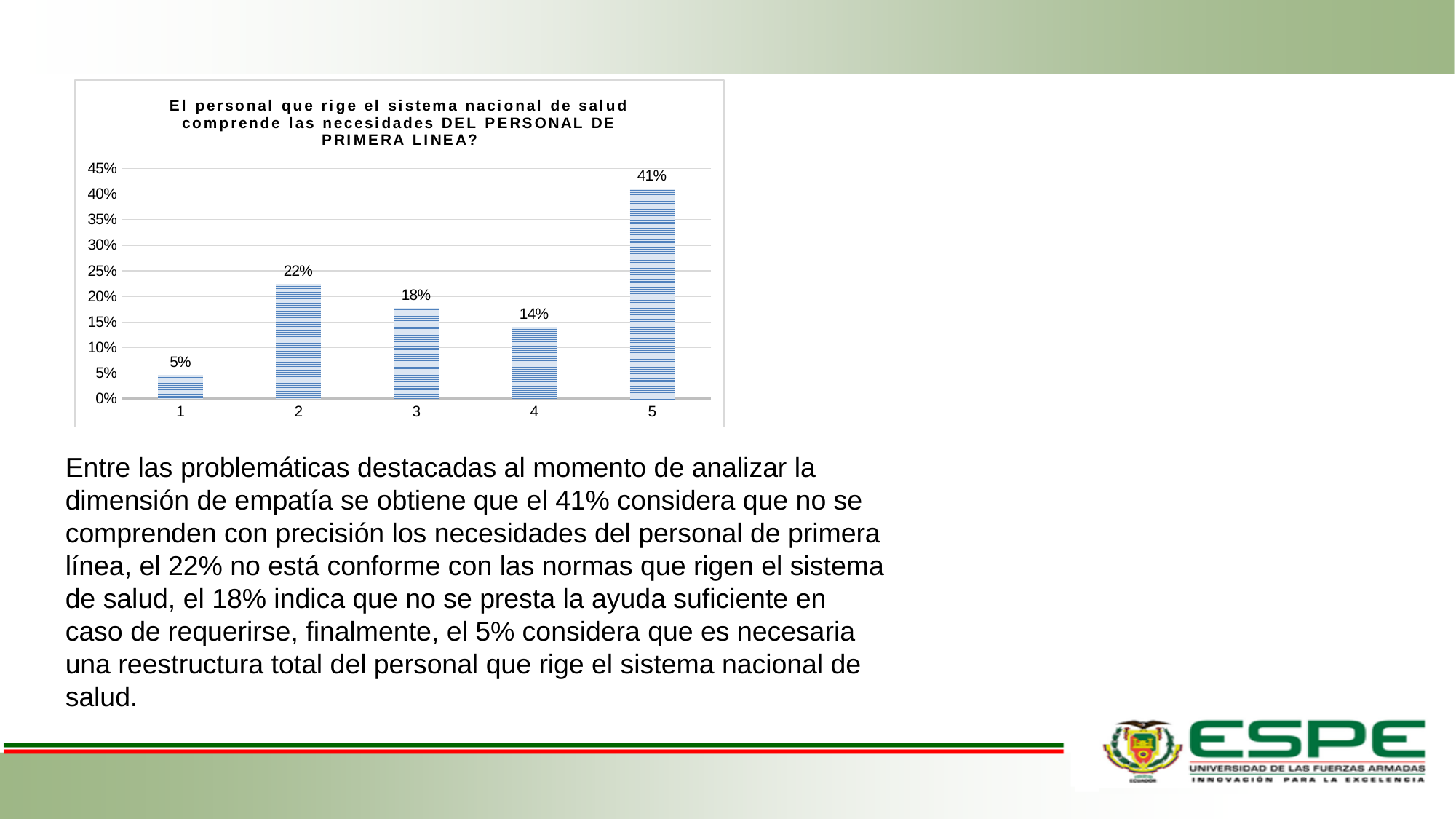
What is the highest value shown on the y axis? 45% How many categories are shown on the x axis? 5 Which category has the highest value? 5 Is the value for category 5 greater or less than 40%? greater What is the value for category 5? 41% What is the value for category 2? 22% What is the difference between the values for category 5 and category 2? 19% Which is larger, the value for category 3 or the value for category 4? 3 Which category has the lowest value? 1 What is the difference between the values for category 3 and category 1? 13% What is the value for category 4? 14% What kind of chart is shown on the slide? bar chart